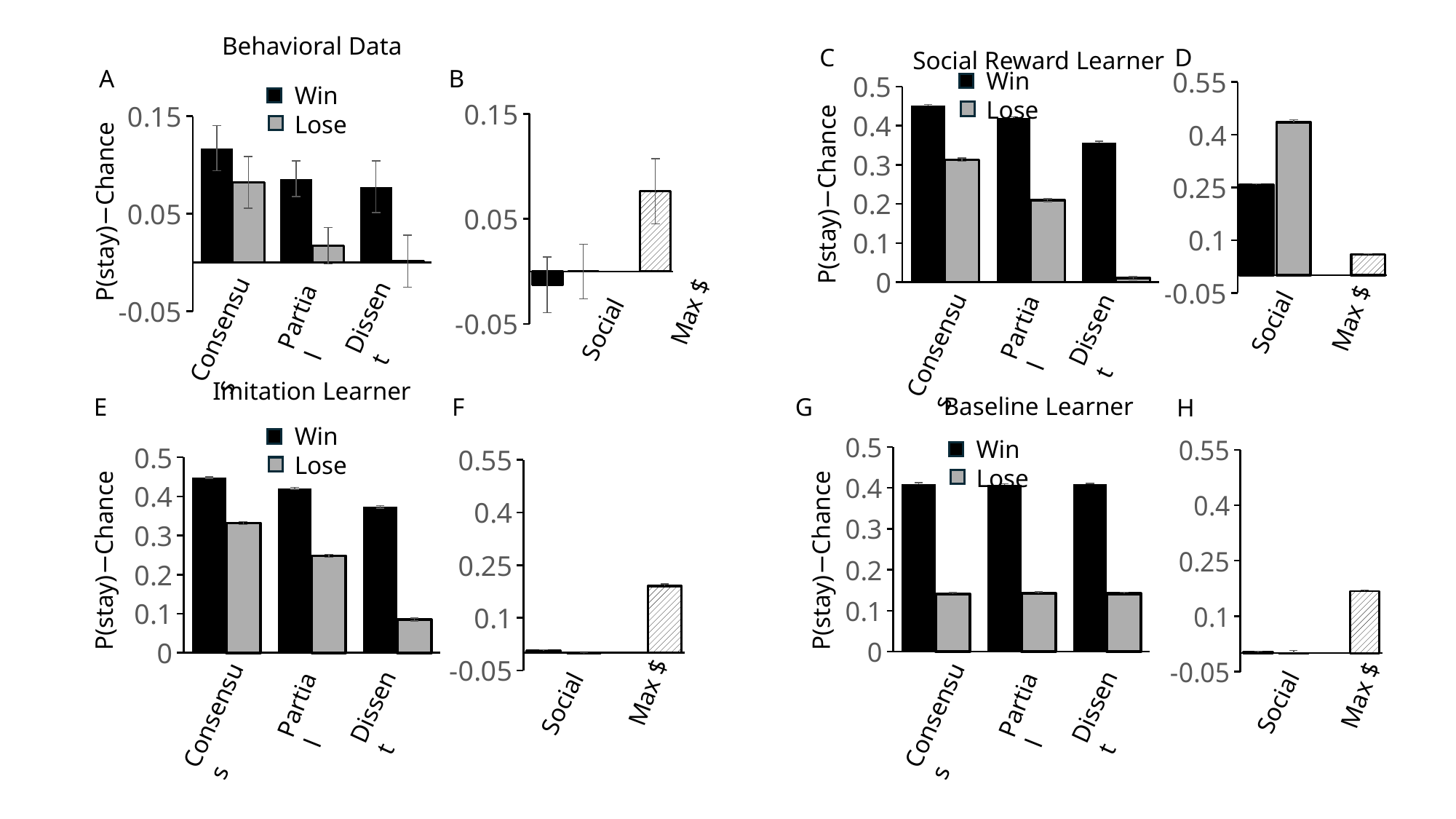
In panel C (Social Reward Learner), which category has the highest Win bar? Consensus In panel G (Baseline Learner), is the Lose value for Consensus greater or less than 0.1? greater In panel A (Behavioral Data), how many series does the legend list? 2 In panel E (Imitation Learner), which category has the lowest Lose bar? Dissent In panel F (Imitation Learner, right), is the Max $ value greater or less than 0.1? greater What kind of chart is panel C (Social Reward Learner)? bar chart In panel D (top right), which is larger for Social: the Win bar or the Lose bar? Lose In panel A (Behavioral Data), how many categories are shown on the x axis? 3 In panel C (Social Reward Learner), is the Lose value for Dissent greater or less than 0.1? less What is the y-axis label of panel E (Imitation Learner)? P(stay)−Chance In panel B (Behavioral Data, right), which is larger: the Social bar or the Max $ bar? Max $